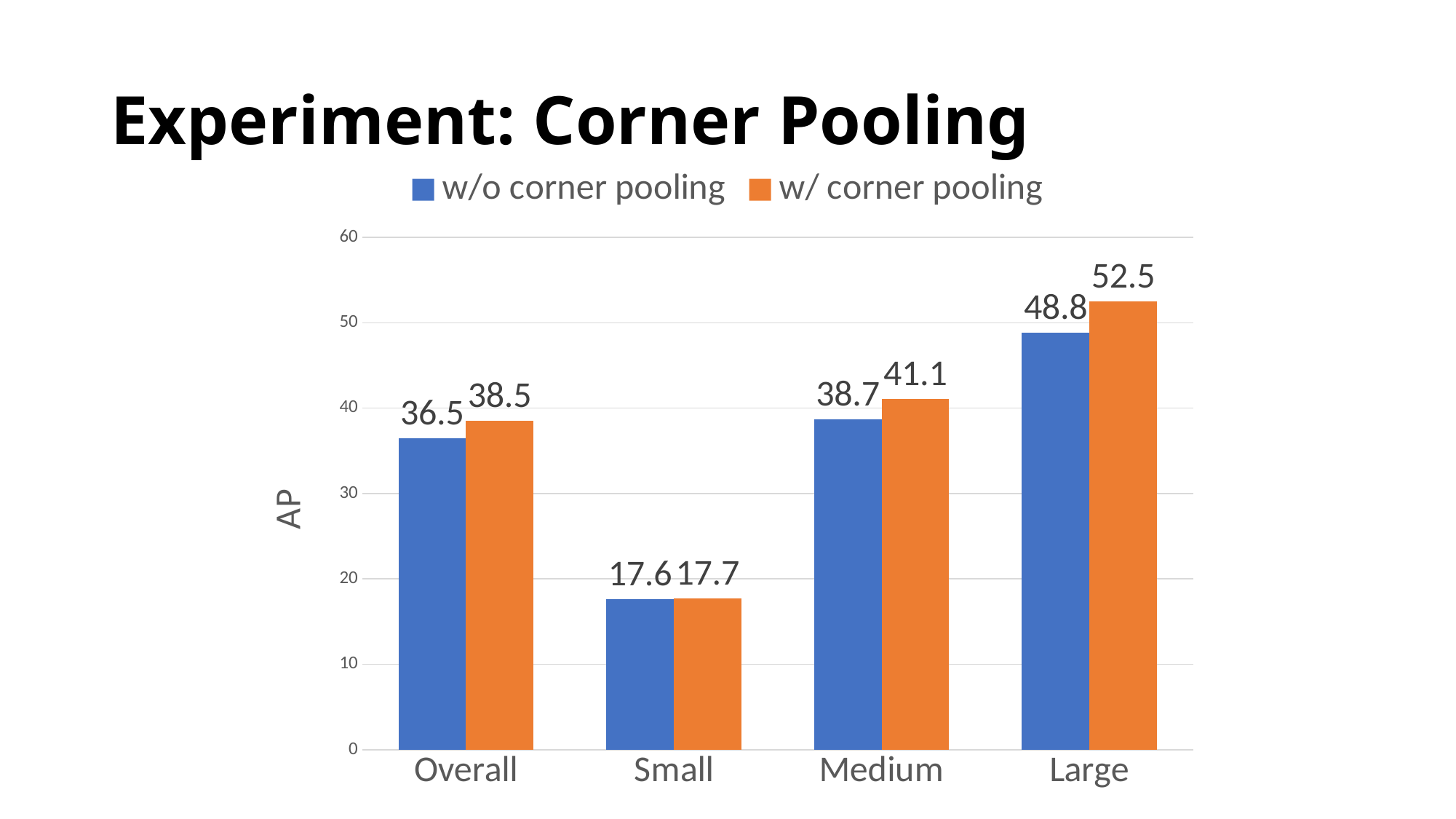
What is the difference in AP between w/ corner pooling and w/o corner pooling for Overall? 2.0 How many series does the legend list? 2 What type of chart is shown on the slide? Bar chart Which category has the highest AP for the w/ corner pooling series? Large What is the AP for Medium with corner pooling? 41.1 Which category has the lowest AP for the w/o corner pooling series? Small Is the AP for Large without corner pooling greater or less than 40? greater What is the AP for Overall without corner pooling? 36.5 What is the difference in AP between w/ corner pooling and w/o corner pooling for Large? 3.7 How many categories are shown on the x axis? 4 Which is larger: the AP for Medium with corner pooling or the AP for Overall with corner pooling? Medium with corner pooling What is the AP for Large with corner pooling? 52.5